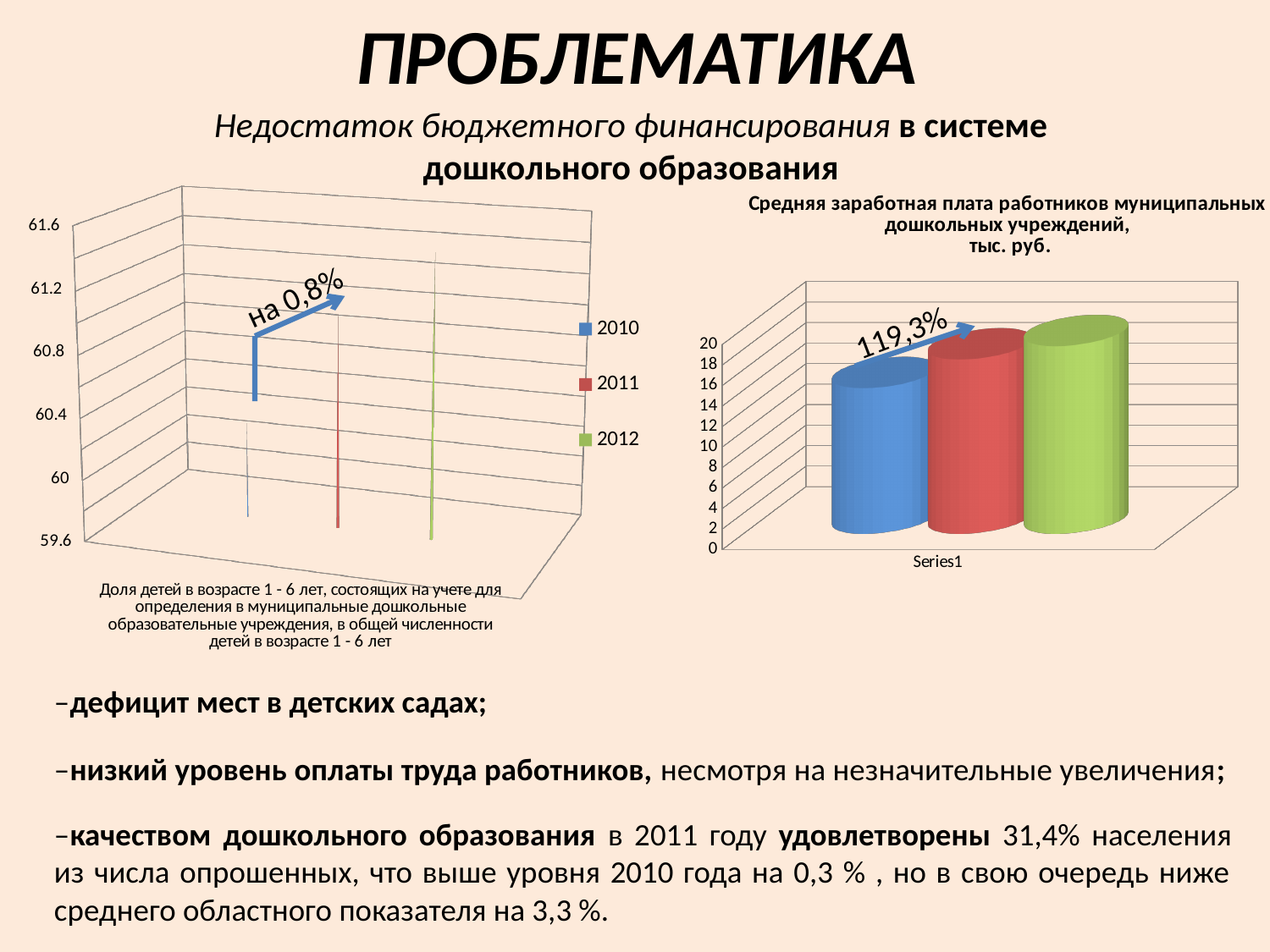
What kind of chart is the chart on the right, titled 'Средняя заработная плата работников муниципальных дошкольных учреждений'? bar chart How many bars are plotted in the right chart? 3 In the left chart, do the bars rise or fall from 2010 to 2012? rise In the right chart, which bar is the shortest? the blue (leftmost) bar What kind of chart is the chart on the left of the slide? bar chart In what units are the values of the right chart given, according to its title? тыс. руб. In the right chart, is the value of the blue bar greater or less than 10? greater In the right chart, which bar is the tallest? the green (rightmost) bar In the right chart, is the value of the blue bar greater or less than 20? less How many series does the legend of the left chart list? 3 What are the legend entries of the left chart? 2010, 2011, 2012 In the right chart, do the bars rise or fall from left to right? rise